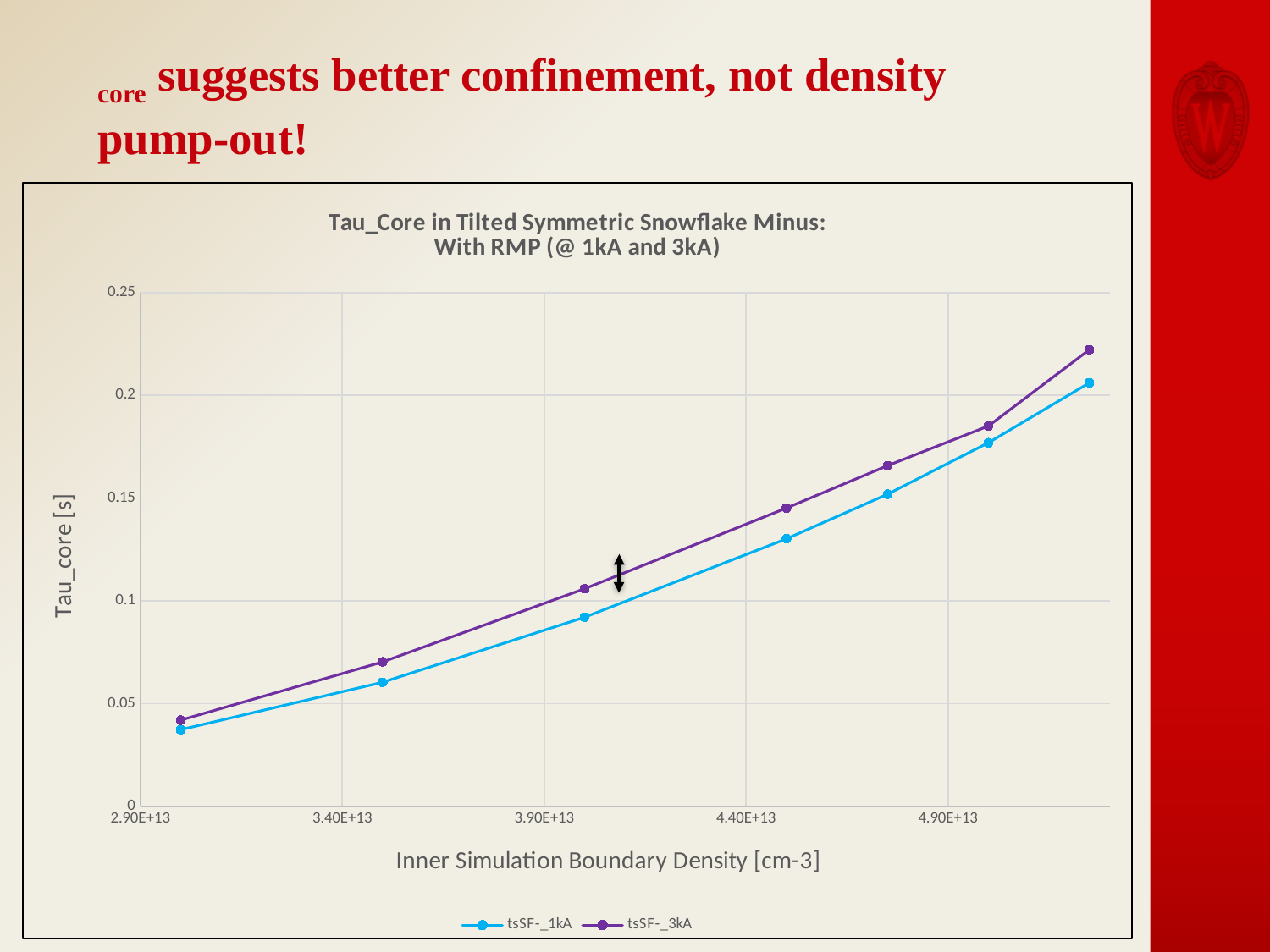
Which series has the higher Tau_core values across the density range, tsSF-_1kA or tsSF-_3kA? tsSF-_3kA What is the label of the y axis? Tau_core [s] Do the Tau_core values rise or fall as the inner simulation boundary density increases? rise How many series does the legend list? 2 What is the label of the x axis? Inner Simulation Boundary Density [cm-3] Is the highest Tau_core value of the tsSF-_3kA series greater or less than 0.2? greater What kind of chart is shown on the slide? line chart Is the lowest Tau_core value of the tsSF-_1kA series greater or less than 0.05? less How many data points are plotted for the tsSF-_3kA series? 7 Is the Tau_core value of the tsSF-_3kA series at its fourth data point (just right of 3.90E+13) greater or less than 0.1? greater Which series reaches the highest Tau_core value on the chart? tsSF-_3kA